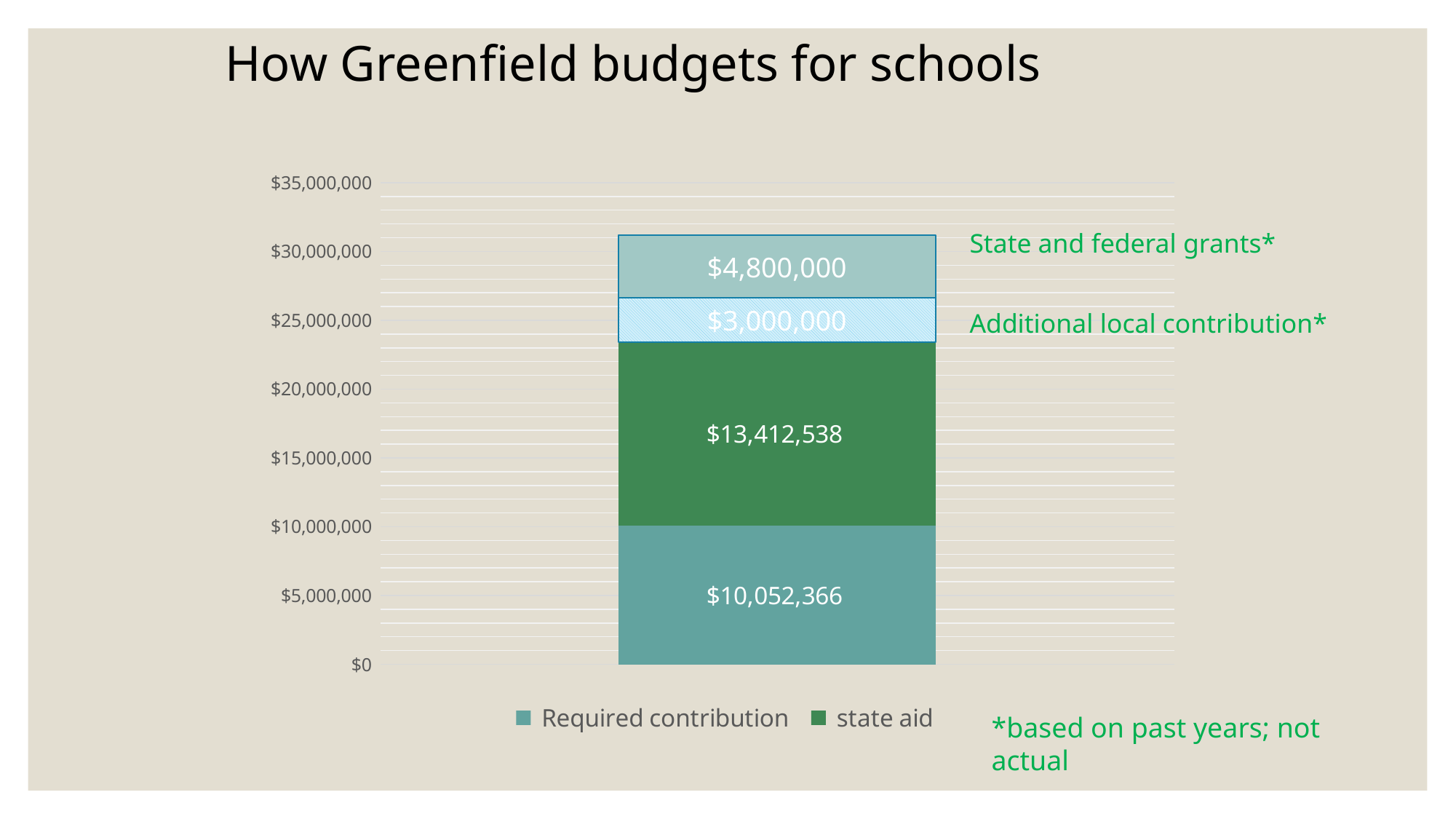
What is the value of the state aid segment? $13,412,538 What value is shown for State and federal grants? $4,800,000 What value is shown for Additional local contribution? $3,000,000 Which is larger, State and federal grants or Additional local contribution? State and federal grants What is the total of all four segments in the stacked bar? $31,264,904 Which segment of the bar has the largest value? state aid What kind of chart is shown on the slide? Stacked bar chart How many series does the legend list? 2 How much larger is state aid than the Required contribution? $3,360,172 What is the title of the slide? How Greenfield budgets for schools What is the value of the Required contribution segment? $10,052,366 Which segment of the bar has the smallest value? Additional local contribution